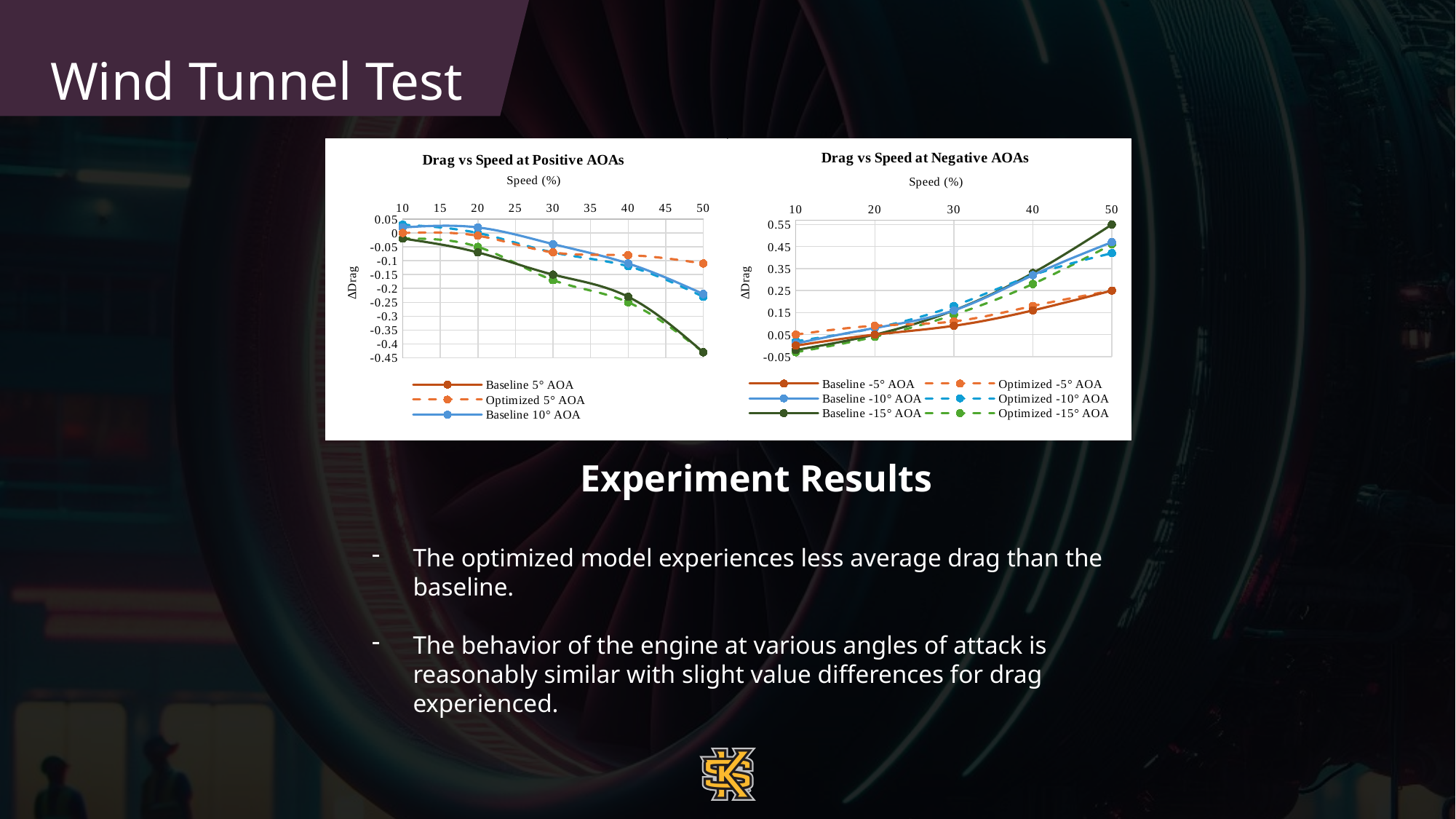
In the 'Drag vs Speed at Positive AOAs' chart, at speed 50, which is larger: Optimized 5° AOA or Baseline 10° AOA? Optimized 5° AOA In the 'Drag vs Speed at Positive AOAs' chart, do the values generally rise or fall as speed increases? fall In the 'Drag vs Speed at Negative AOAs' chart, at speed 50, which is larger: Baseline -15° AOA or Baseline -5° AOA? Baseline -15° AOA In the 'Drag vs Speed at Positive AOAs' chart, is the value for Optimized 5° AOA at speed 50 greater or less than 0? less In the 'Drag vs Speed at Negative AOAs' chart, is the value for Baseline -15° AOA at speed 50 greater or less than 0.45? greater In the 'Drag vs Speed at Negative AOAs' chart, how many series does the legend list? 6 In the 'Drag vs Speed at Negative AOAs' chart, which series has the highest value at speed 50? Baseline -15° AOA In the 'Drag vs Speed at Negative AOAs' chart, do the values generally rise or fall as speed increases? rise In the 'Drag vs Speed at Negative AOAs' chart, is the value for Baseline -5° AOA at speed 50 greater or less than 0.35? less What kind of chart is the 'Drag vs Speed at Positive AOAs' chart? line chart What is the label of the y axis on the 'Drag vs Speed at Positive AOAs' chart? ΔDrag In the 'Drag vs Speed at Negative AOAs' chart, how many speed points are plotted along the x axis? 5